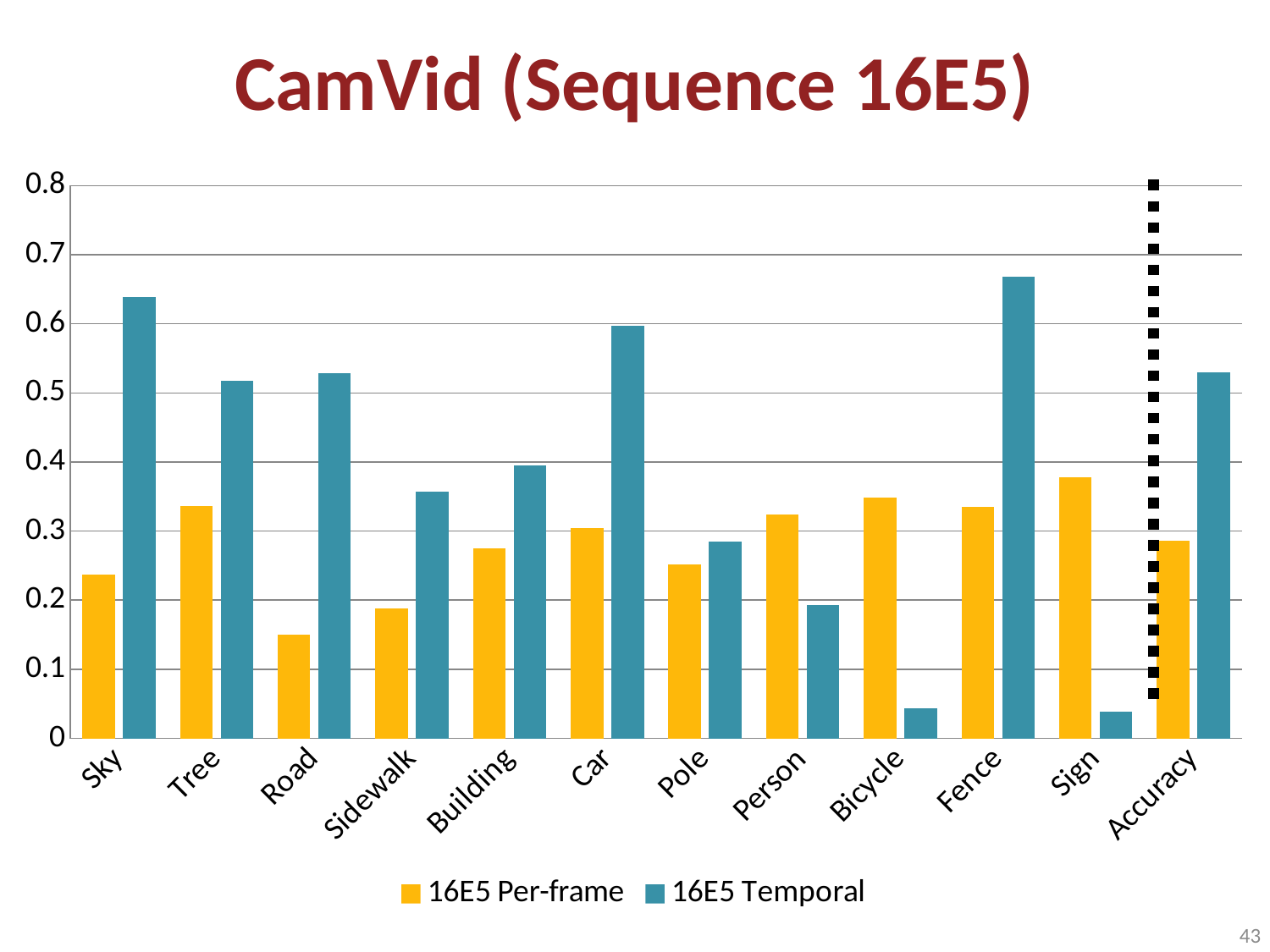
Which category has the highest 16E5 Temporal value? Fence How many series does the legend list? 2 Is the 16E5 Temporal value for Sky greater or less than 0.6? greater Is the 16E5 Per-frame value for Road greater or less than 0.2? less Which category has the highest 16E5 Per-frame value? Sign What is the title of the chart? CamVid (Sequence 16E5) How many categories are shown on the x axis? 12 Is the 16E5 Temporal value for Bicycle greater or less than 0.1? less Which category has the lowest 16E5 Per-frame value? Road For Person, which series has the larger value, 16E5 Per-frame or 16E5 Temporal? 16E5 Per-frame What kind of chart is shown on the slide? bar chart